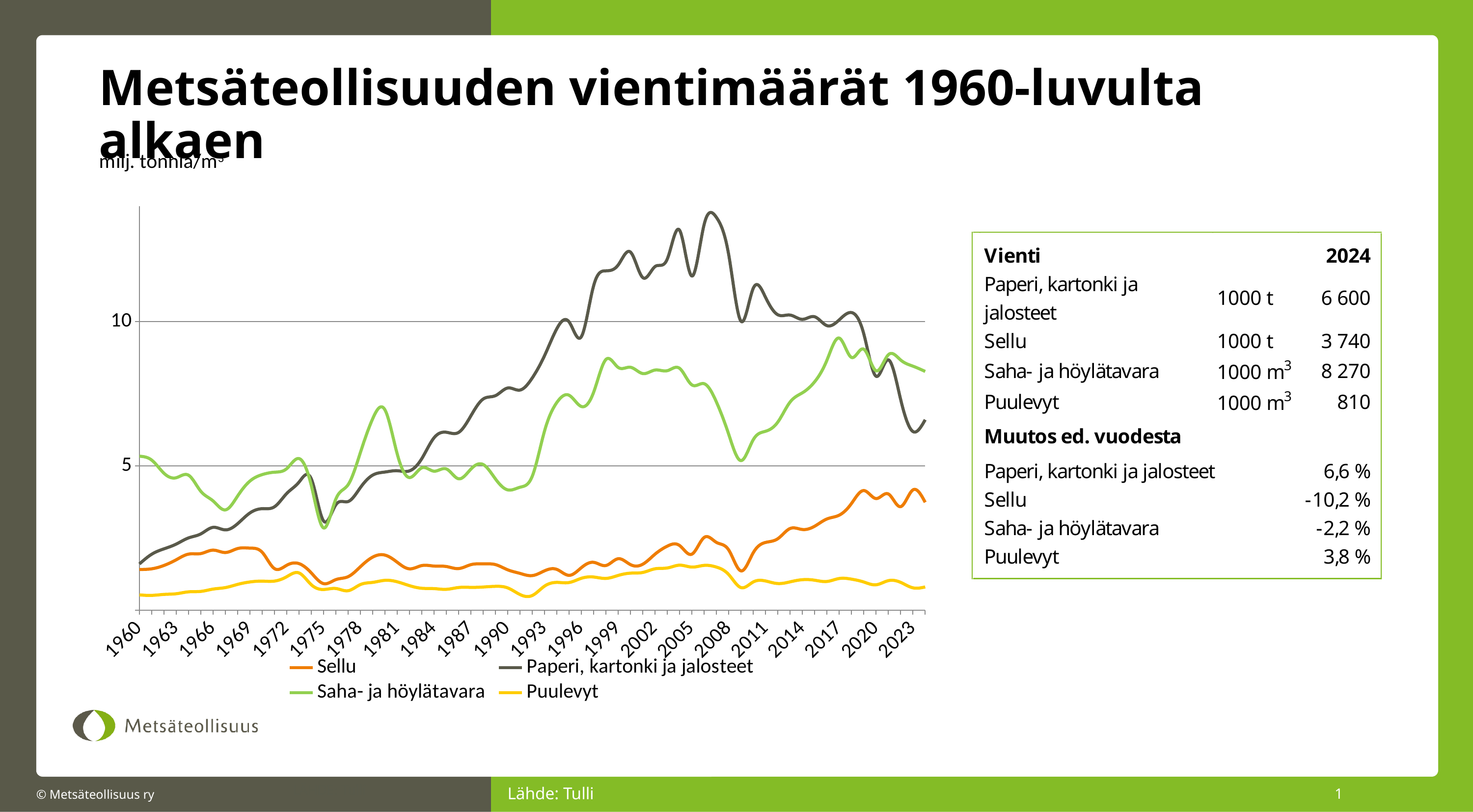
Which series reaches the highest value on the chart around 2008? Paperi, kartonki ja jalosteet Is the value for Paperi, kartonki ja jalosteet in 2020 greater or less than 10? less Which series has the lowest values across the whole period shown? Puulevyt Does the Sellu line rise or fall from 2010 to 2020? rise Is the value for Sellu in 1960 greater or less than 5? less Is the value for Saha- ja höylätavara in 2023 greater or less than 5? greater What unit is given for the chart's vertical axis? milj. tonnia/m³ What kind of chart is shown on the slide? line chart Does the Paperi, kartonki ja jalosteet line rise or fall from 2008 to 2023? fall In 2023, which is larger: Saha- ja höylätavara or Paperi, kartonki ja jalosteet? Saha- ja höylätavara How many series does the chart legend list? 4